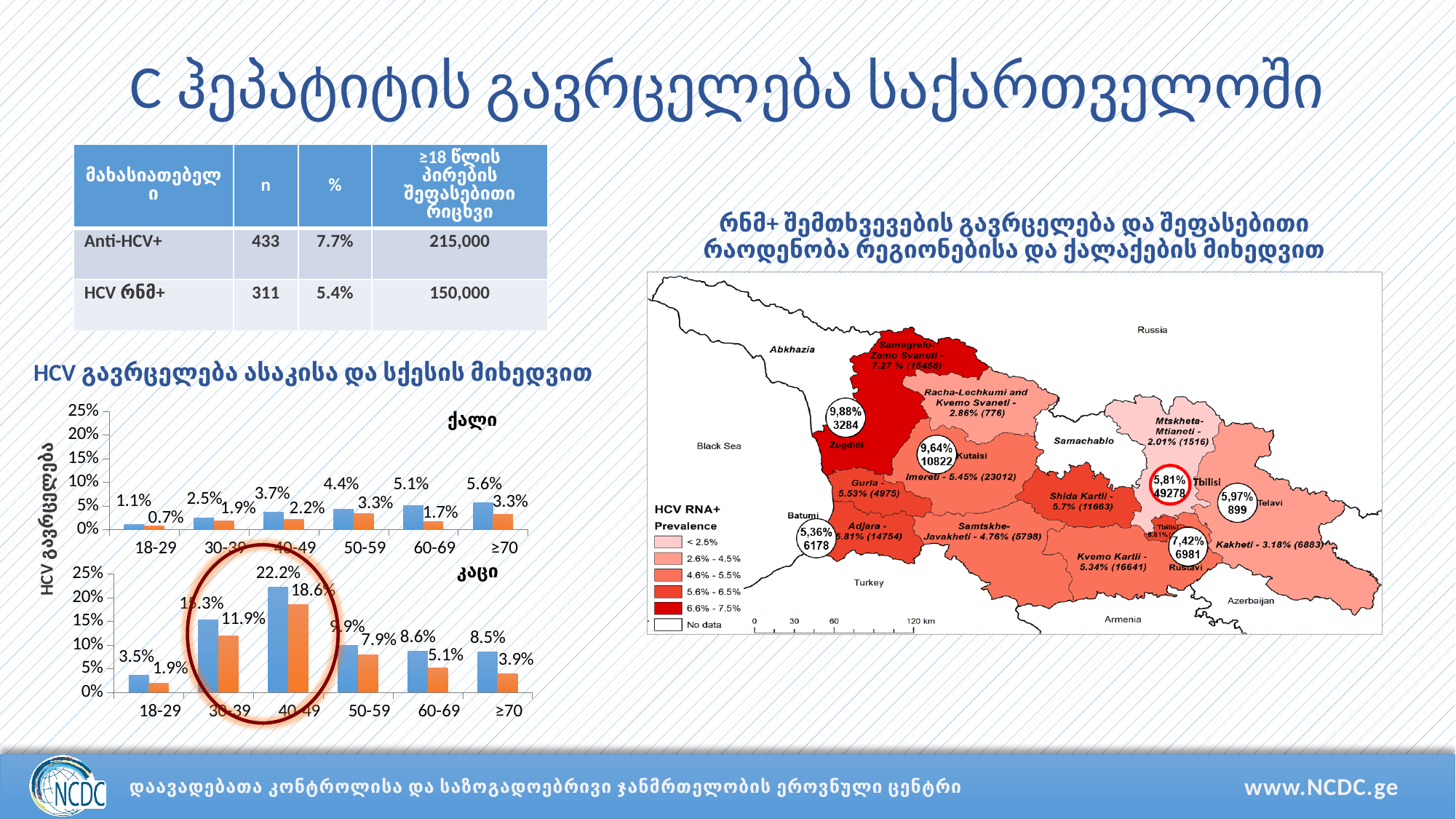
In the bottom bar chart (კაცი), what is the value of the orange bar for the 30-39 age group? 11.9% In the bottom bar chart (კაცი), is the blue bar for 40-49 greater or less than 20%? greater In the bottom bar chart (კაცი), which age group has the highest blue bar? 40-49 How many age groups are shown on the x axis of the top bar chart (ქალი)? 6 In the top bar chart (ქალი), what is the value of the blue bar for the ≥70 age group? 5.6% In the bottom bar chart (კაცი), what is the value of the blue bar for the 40-49 age group? 22.2% In the bottom bar chart (კაცი), what is the difference between the blue and orange bars for the 40-49 age group? 3.6% In the top bar chart (ქალი), what is the value of the orange bar for the 18-29 age group? 0.7% In the top bar chart (ქალი), do the blue bars rise or fall as age increases from 18-29 to ≥70? Rise In the top bar chart (ქალი), which age group has the lowest blue bar? 18-29 In the bottom bar chart (კაცი), is the blue bar for 30-39 or the blue bar for 50-59 larger? 30-39 What type of chart is used to show HCV prevalence by age and sex on the left of the slide? Bar chart